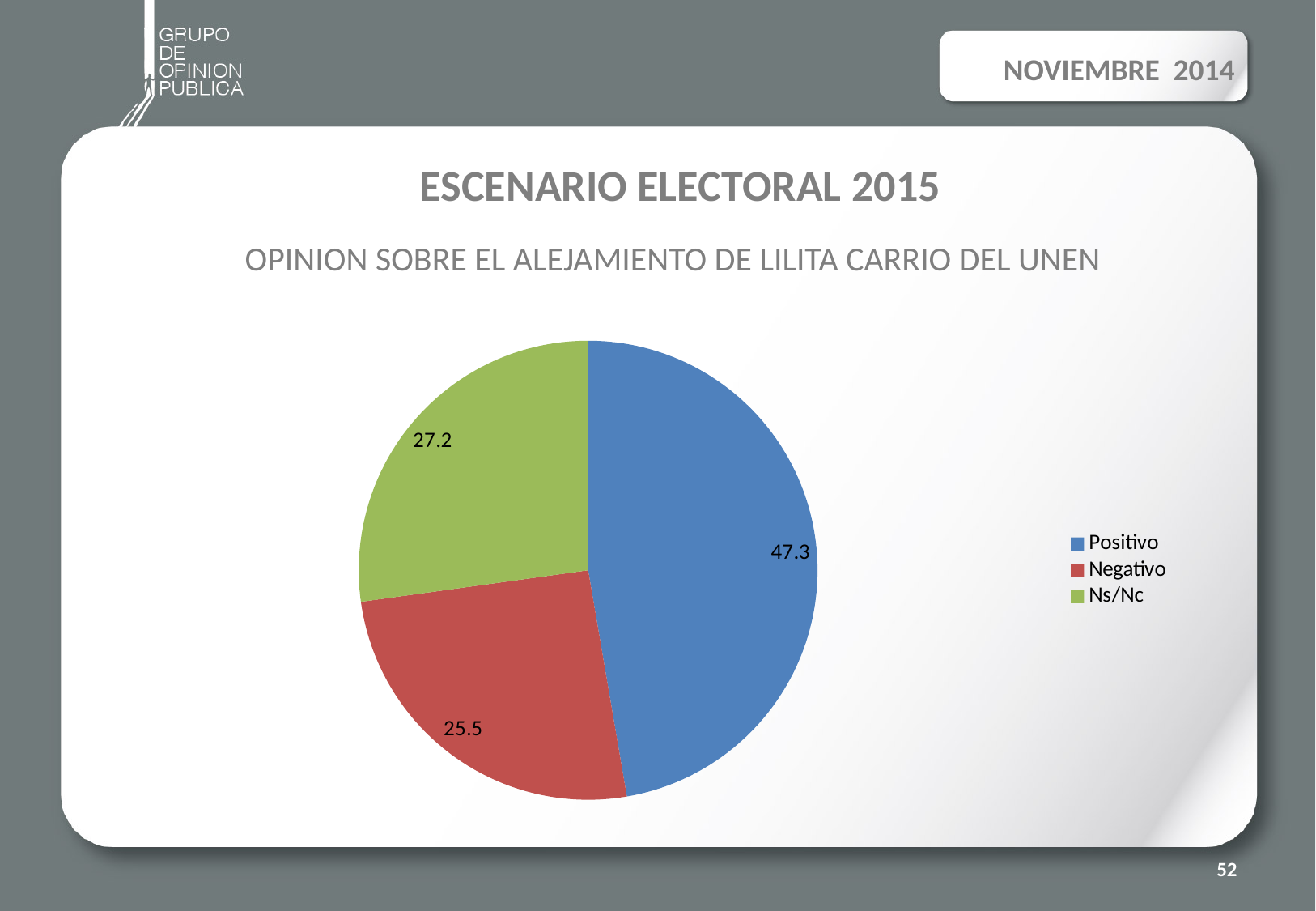
What is the value for Negativo? 25.5 What is the value for Positivo? 47.3 Which is larger, the value for Positivo or the value for Ns/Nc? Positivo What is the difference between the values for Positivo and Negativo? 21.8 How many categories does the legend list? 3 What kind of chart is shown on the slide? pie chart What is the difference between the values for Ns/Nc and Negativo? 1.7 What is the subtitle of the chart on the slide? OPINION SOBRE EL ALEJAMIENTO DE LILITA CARRIO DEL UNEN Which category has the largest slice? Positivo What colour is the Negativo slice? red Which category has the smallest slice? Negativo What is the value for Ns/Nc? 27.2